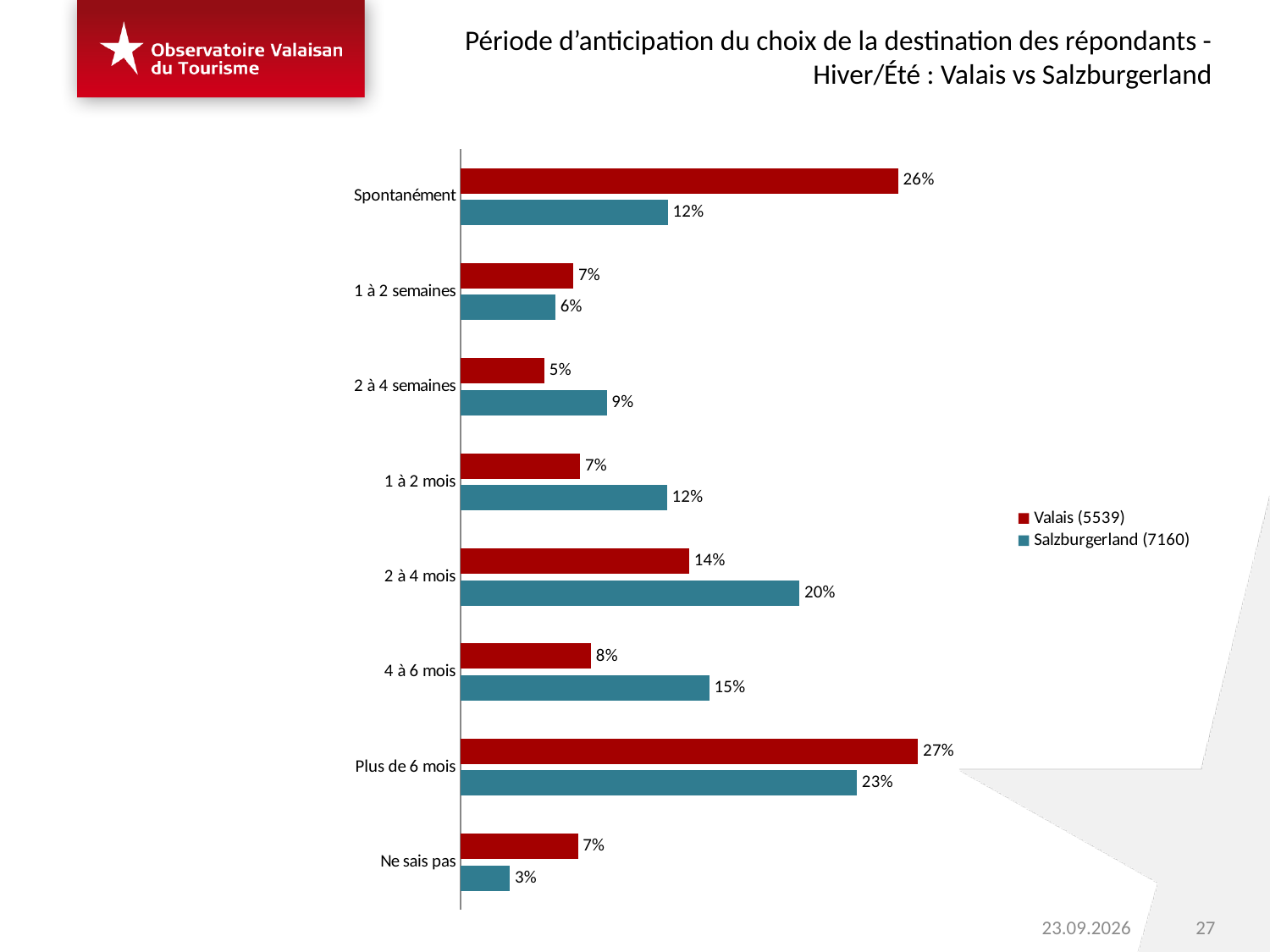
What is the value for Salzburgerland (7160) in the 2 à 4 mois category? 20% How many series does the legend list? 2 Which is larger for 4 à 6 mois: the Valais (5539) value or the Salzburgerland (7160) value? Salzburgerland (7160) What is the value for Valais (5539) in the Spontanément category? 26% Which category has the highest value for Valais (5539)? Plus de 6 mois What kind of chart is shown on the slide? Bar chart Which category has the lowest value for Salzburgerland (7160)? Ne sais pas What is the difference between the Valais (5539) and Salzburgerland (7160) values for Spontanément? 14% What is the value for Salzburgerland (7160) in the Ne sais pas category? 3% Which colour represents Valais (5539) in the chart? Red What is the difference between the Salzburgerland (7160) and Valais (5539) values for 2 à 4 semaines? 4% How many categories are shown on the chart? 8